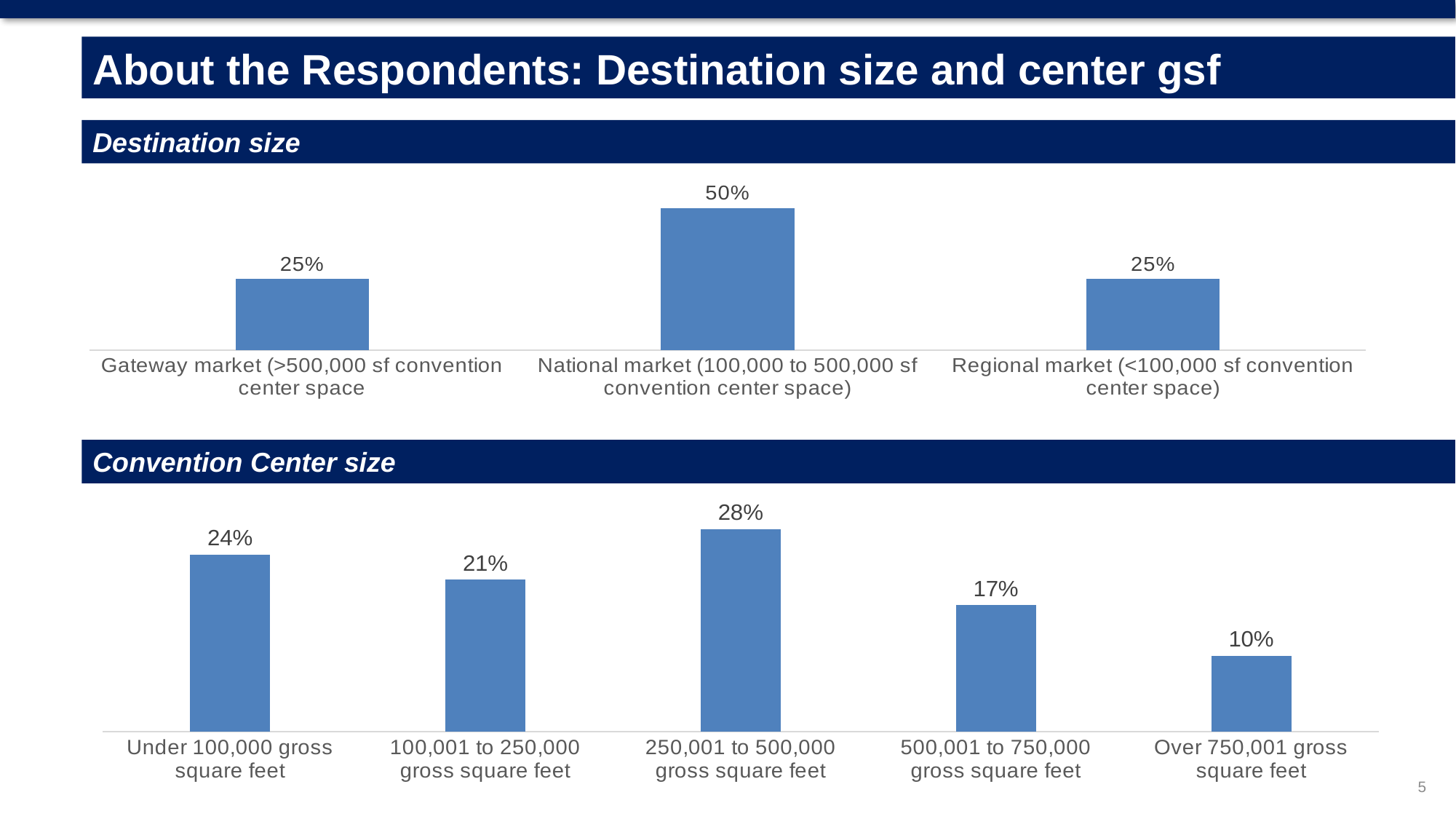
In the Destination size chart, what is the value for National market (100,000 to 500,000 sf convention center space)? 50% In the Destination size chart, how many categories are shown? 3 In the Convention Center size chart, what is the value for Over 750,001 gross square feet? 10% In the Destination size chart, which category has the highest value? National market (100,000 to 500,000 sf convention center space) In the Convention Center size chart, what is the difference between the values for 500,001 to 750,000 gross square feet and Over 750,001 gross square feet? 7% In the Destination size chart, what is the value for Gateway market (>500,000 sf convention center space)? 25% In the Convention Center size chart, what is the value for 250,001 to 500,000 gross square feet? 28% In the Destination size chart, what is the difference between the National market value and the Regional market value? 25% In the Convention Center size chart, how many categories are shown? 5 What kind of chart is the Convention Center size chart? Bar chart In the Convention Center size chart, which is larger: Under 100,000 gross square feet or 100,001 to 250,000 gross square feet? Under 100,000 gross square feet In the Convention Center size chart, which category has the lowest value? Over 750,001 gross square feet